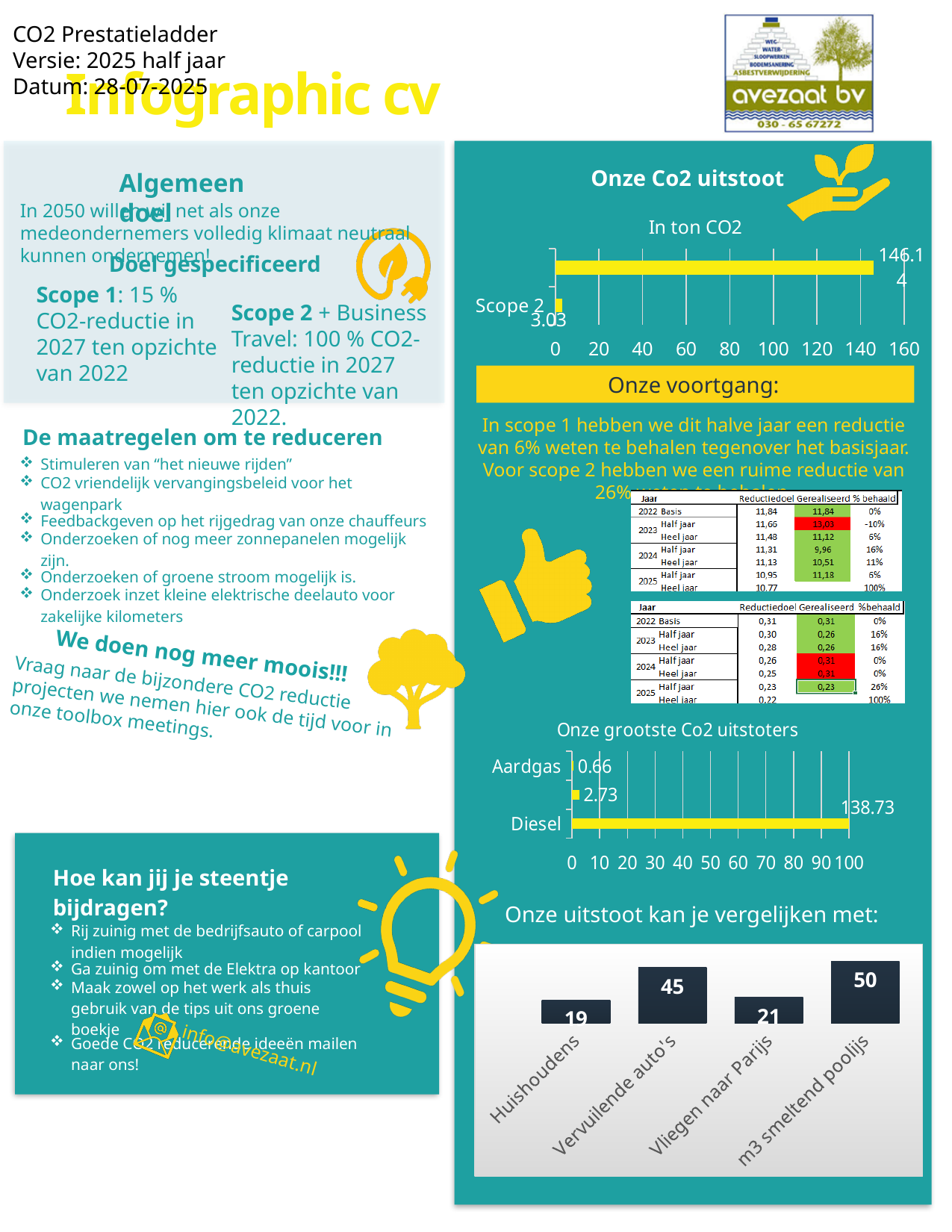
In the 'Onze Co2 uitstoot' chart, what is the value for Scope 2? 3.03 In the 'Onze grootste Co2 uitstoters' chart, what is the difference between Diesel and Aardgas? 138.07 In the 'Onze uitstoot kan je vergelijken met' chart, what is the difference between m3 smeltend poolijs and Vliegen naar Parijs? 29 How many bars are plotted in the 'Onze grootste Co2 uitstoters' chart? 3 In the 'Onze grootste Co2 uitstoters' chart, what is the value for Diesel? 138.73 In the 'Onze uitstoot kan je vergelijken met' chart, which category has the highest value? m3 smeltend poolijs What kind of chart is the 'Onze Co2 uitstoot' chart? bar chart In the 'Onze uitstoot kan je vergelijken met' chart, what is the value for Vervuilende auto's? 45 In the 'Onze grootste Co2 uitstoters' chart, which category has the highest value? Diesel How many bars are plotted in the 'Onze Co2 uitstoot' chart? 2 In the 'Onze grootste Co2 uitstoters' chart, what is the value for Aardgas? 0.66 In the 'Onze uitstoot kan je vergelijken met' chart, which category has the lowest value? Huishoudens